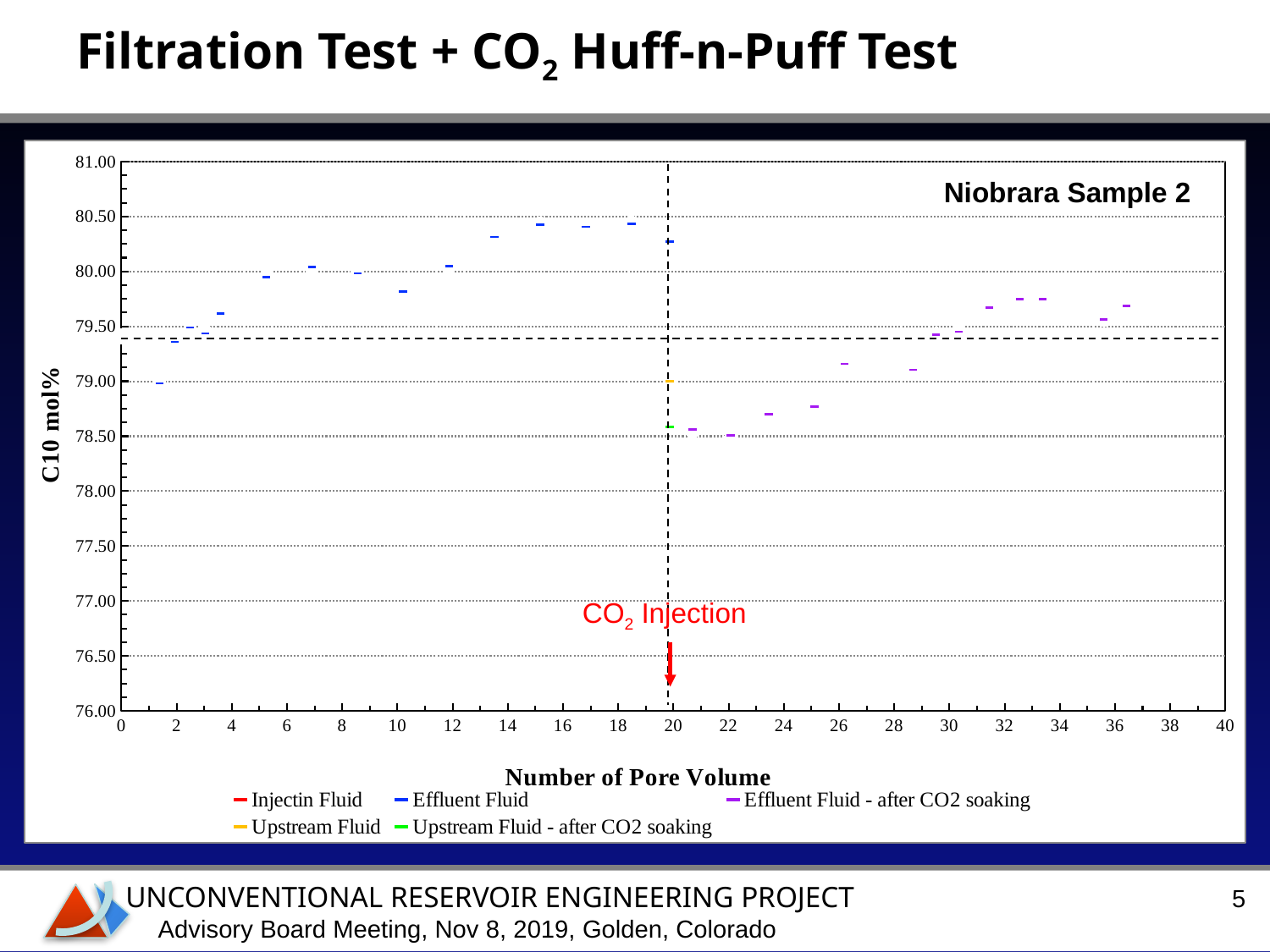
Is the Effluent Fluid - after CO2 soaking value at about 22 pore volumes greater or less than 79.00? less Is the first Effluent Fluid value, at about 1.5 pore volumes, greater or less than 79.50? less What event does the vertical dashed line at pore volume 20 mark? CO2 Injection What kind of chart is shown on the slide? scatter chart How many series does the legend list? 5 Which is larger: the Effluent Fluid value at about 18 pore volumes or the Effluent Fluid - after CO2 soaking value at about 22 pore volumes? Effluent Fluid at about 18 pore volumes Which series reaches the highest C10 mol% value on the chart? Effluent Fluid Is the Effluent Fluid value at about 18 pore volumes greater or less than 80.00? greater What is the title of the x axis? Number of Pore Volume Do the Effluent Fluid values generally rise or fall between 0 and 20 pore volumes? rise Do the Effluent Fluid - after CO2 soaking values generally rise or fall between 22 and 36 pore volumes? rise